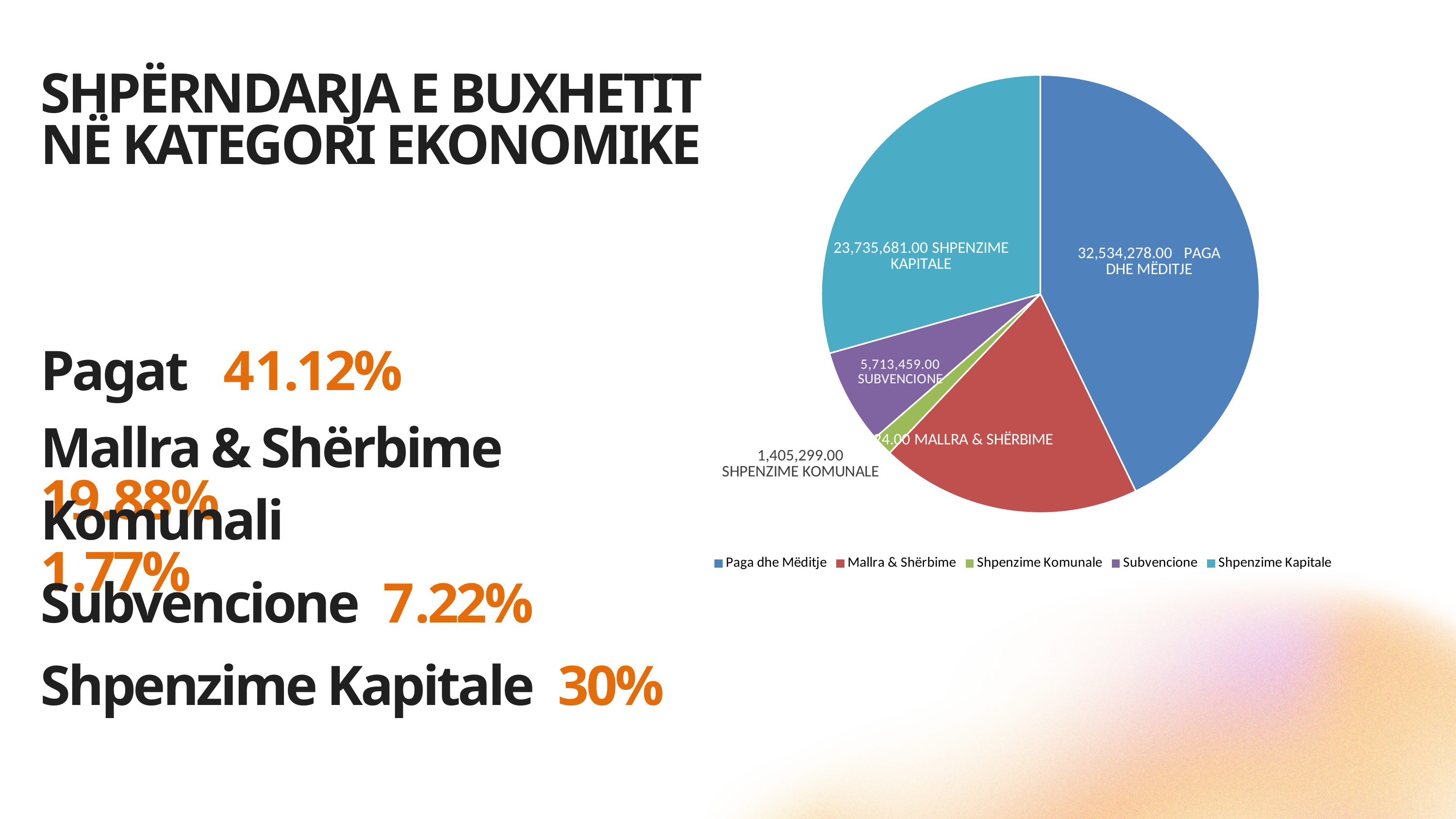
What is the difference between the Paga dhe Mëditje value and the Shpenzime Kapitale value in the pie chart? 8,798,597.00 Which category has the largest slice in the pie chart? Paga dhe Mëditje What type of chart is shown on the slide? Pie chart What is the value of the Paga dhe Mëditje slice in the pie chart? 32,534,278.00 How many slices does the pie chart have? 5 What colour is the Paga dhe Mëditje slice in the pie chart? Blue Which category has the smallest slice in the pie chart? Shpenzime Komunale What is the value of the Shpenzime Kapitale slice in the pie chart? 23,735,681.00 What is the value of the Shpenzime Komunale slice in the pie chart? 1,405,299.00 What is the value of the Subvencione slice in the pie chart? 5,713,459.00 What is the difference between the Subvencione value and the Shpenzime Komunale value in the pie chart? 4,308,160.00 Which is larger in the pie chart, Subvencione or Shpenzime Komunale? Subvencione